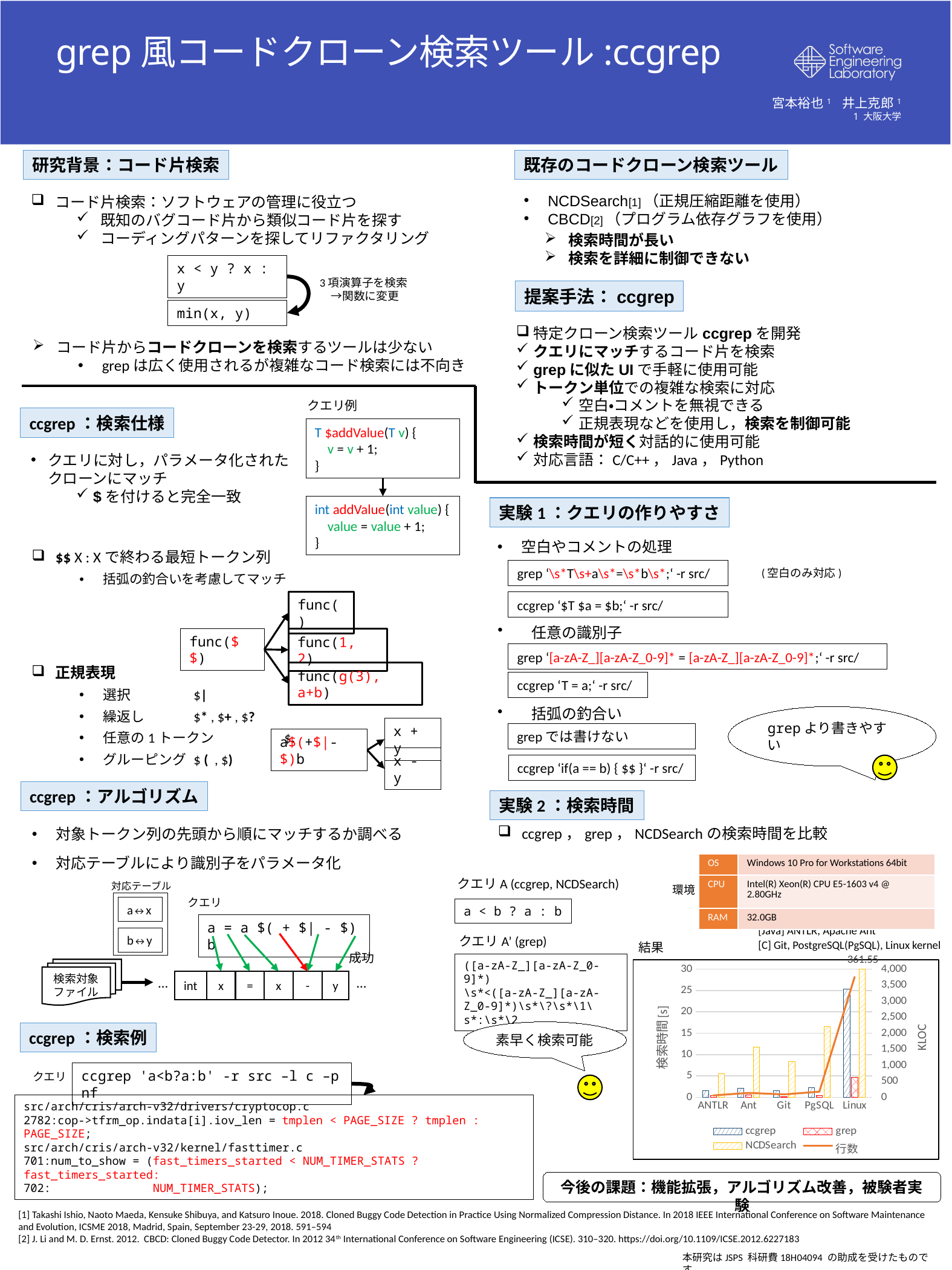
For Linux, which is larger in the search-time chart: the ccgrep bar or the grep bar? ccgrep Is the NCDSearch value for Ant greater or less than 10 in the search-time chart? greater Is the grep value for Linux greater or less than 10 in the search-time chart? less Which category has the highest NCDSearch bar in the search-time chart? Linux What value is printed as a data label at the top of the Linux NCDSearch bar in the search-time chart? 361.55 Does the 行数 line in the search-time chart rise or fall from ANTLR to Linux? rises What kind of chart is shown in the 実験2：検索時間 section? bar chart (with a line series) How many categories are shown on the x axis of the search-time chart? 5 How many series does the legend of the search-time chart list? 4 What is the title of the left vertical axis of the search-time chart? 検索時間 [s] Which category has the lowest NCDSearch bar in the search-time chart? ANTLR Is the ccgrep value for Linux greater or less than 20 in the search-time chart? greater